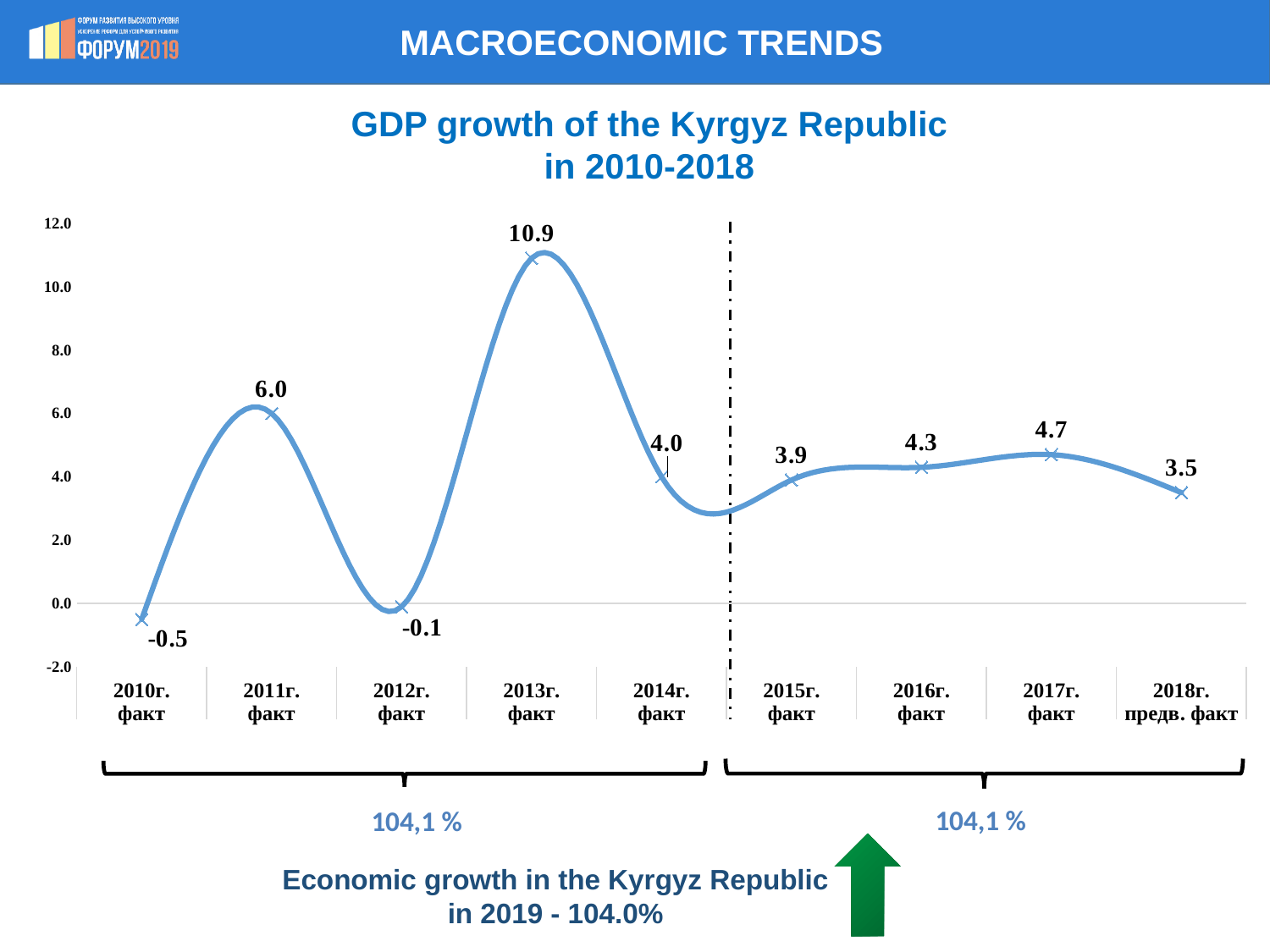
What is the difference between the GDP growth values for 2013г. факт and 2011г. факт? 4.9 What is the GDP growth value for 2010г. факт? -0.5 What is the title of the chart? GDP growth of the Kyrgyz Republic in 2010-2018 What is the GDP growth value for 2016г. факт? 4.3 Is the GDP growth value for 2014г. факт greater or less than 6.0? less Which year has the lowest GDP growth value? 2010г. факт What is the GDP growth value for 2018г. предв. факт? 3.5 Which is larger, the GDP growth value for 2017г. факт or for 2015г. факт? 2017г. факт How many years are plotted on the chart? 9 Which year has the highest GDP growth value? 2013г. факт What is the GDP growth value for 2013г. факт? 10.9 What kind of chart is shown on the slide? line chart